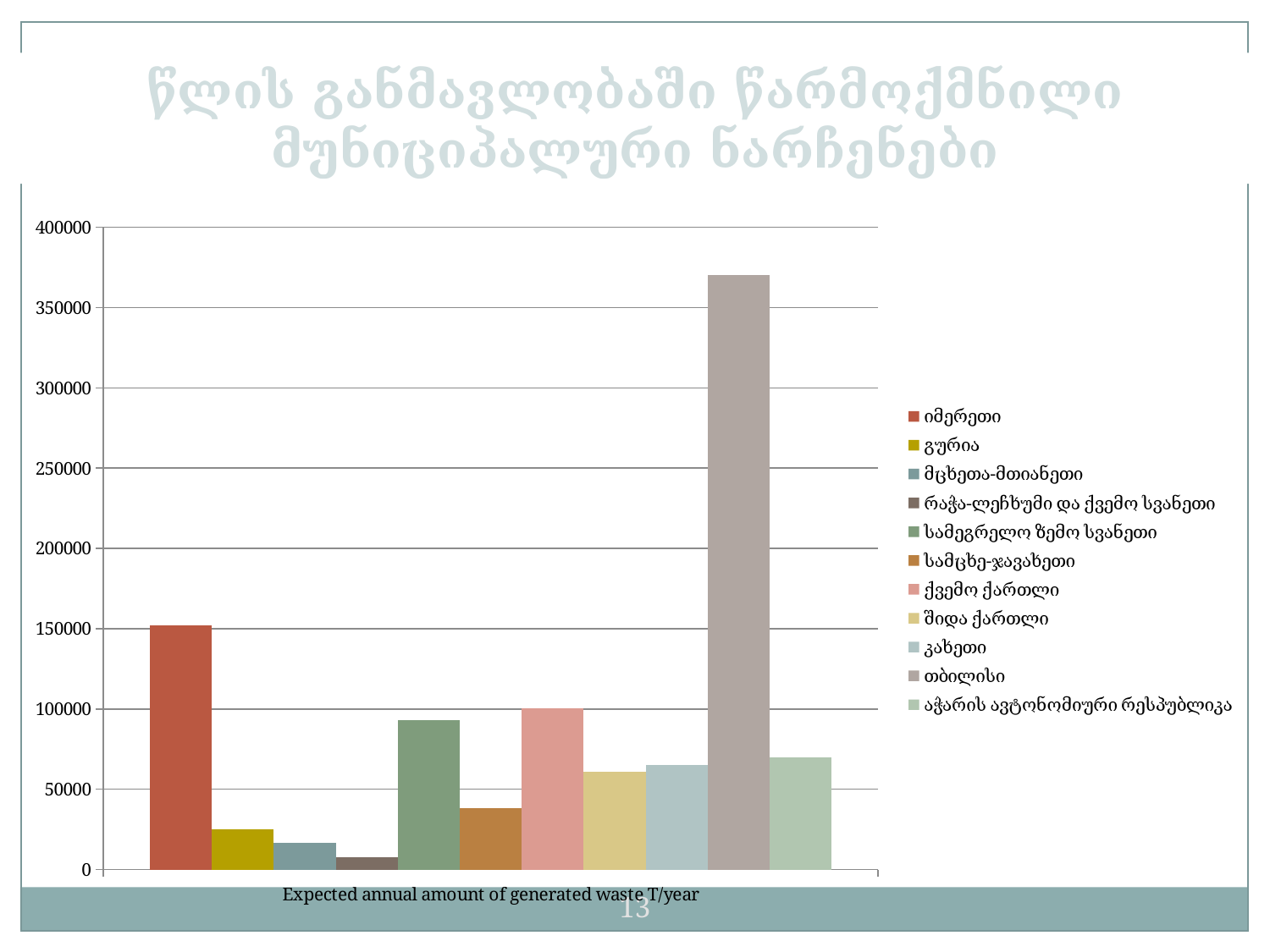
Which is larger, the value for იმერეთი or the value for სამეგრელო ზემო სვანეთი? იმერეთი Is the value for გურია greater or less than 50000? less Which series has the highest value in the chart? თბილისი What is the label shown under the category axis of the chart? Expected annual amount of generated waste T/year Is the value for იმერეთი greater or less than 100000? greater Which is larger, the value for აჭარის ავტონომიური რესპუბლიკა or the value for გურია? აჭარის ავტონომიური რესპუბლიკა What kind of chart is shown on the slide? bar chart Which series has the lowest value in the chart? რაჭა-ლეჩხუმი და ქვემო სვანეთი How many bars are plotted in the chart? 11 Is the value for სამეგრელო ზემო სვანეთი greater or less than 100000? less How many series does the legend list? 11